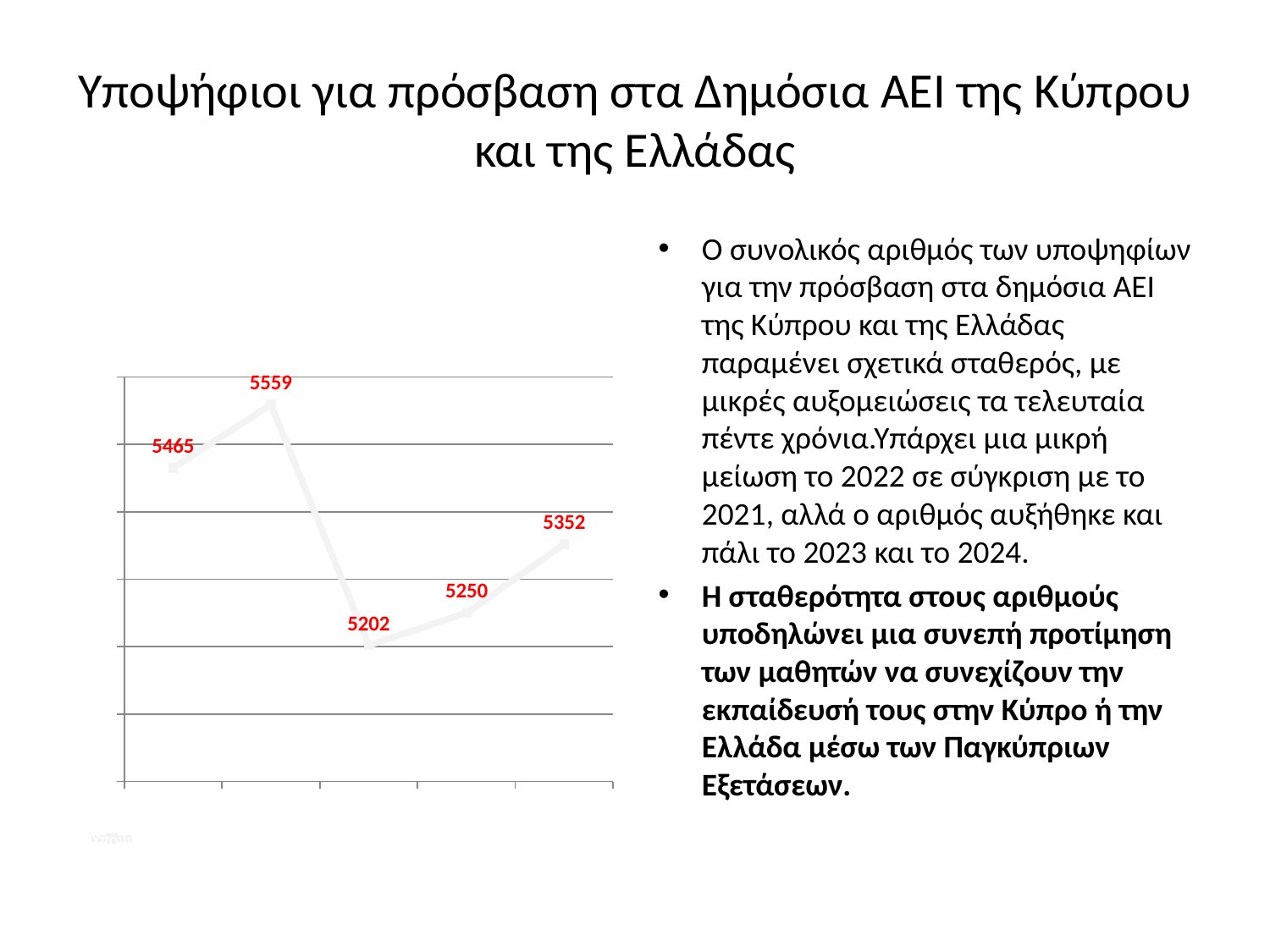
What is the value of the last (rightmost) point on the line chart? 5352 What is the difference between the highest value (5559) and the lowest value (5202) on the line chart? 357 What is the highest value shown on the line chart? 5559 What colour are the data labels on the line chart? red How many data points are plotted on the line chart? 5 What is the value of the fourth point on the line chart? 5250 What is the value of the first (leftmost) point on the line chart? 5465 What kind of chart is shown on the slide? line chart Do the values rise or fall from the third point to the fifth point on the line chart? rise Which is larger: the first point (5465) or the last point (5352) on the line chart? the first point (5465) What is the lowest value shown on the line chart? 5202 What is the difference between the second point (5559) and the first point (5465) on the line chart? 94